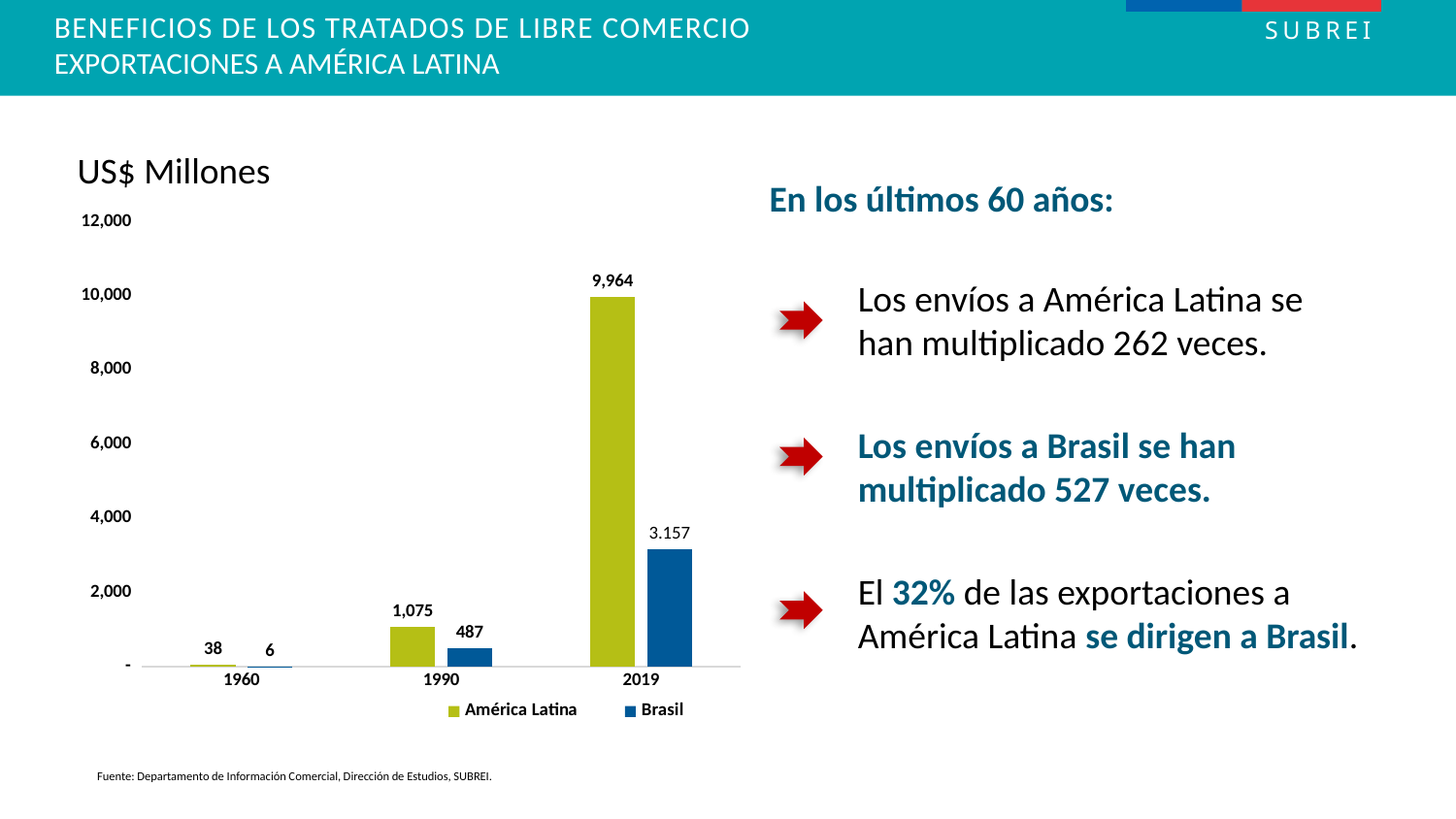
What is the value for América Latina in 1960? 38 What is the difference between the América Latina and Brasil values in 1990? 588 Do the América Latina values rise or fall from 1960 to 2019? rise What is the value for Brasil in 1990? 487 In which year is the Brasil value lowest? 1960 In which year is the América Latina value highest? 2019 Which is larger in 2019, the América Latina value or the Brasil value? América Latina What type of chart is shown on the slide? bar chart What is the value for Brasil in 2019? 3.157 What is the value for América Latina in 2019? 9,964 How many series does the legend list? 2 How many years are shown on the x axis? 3